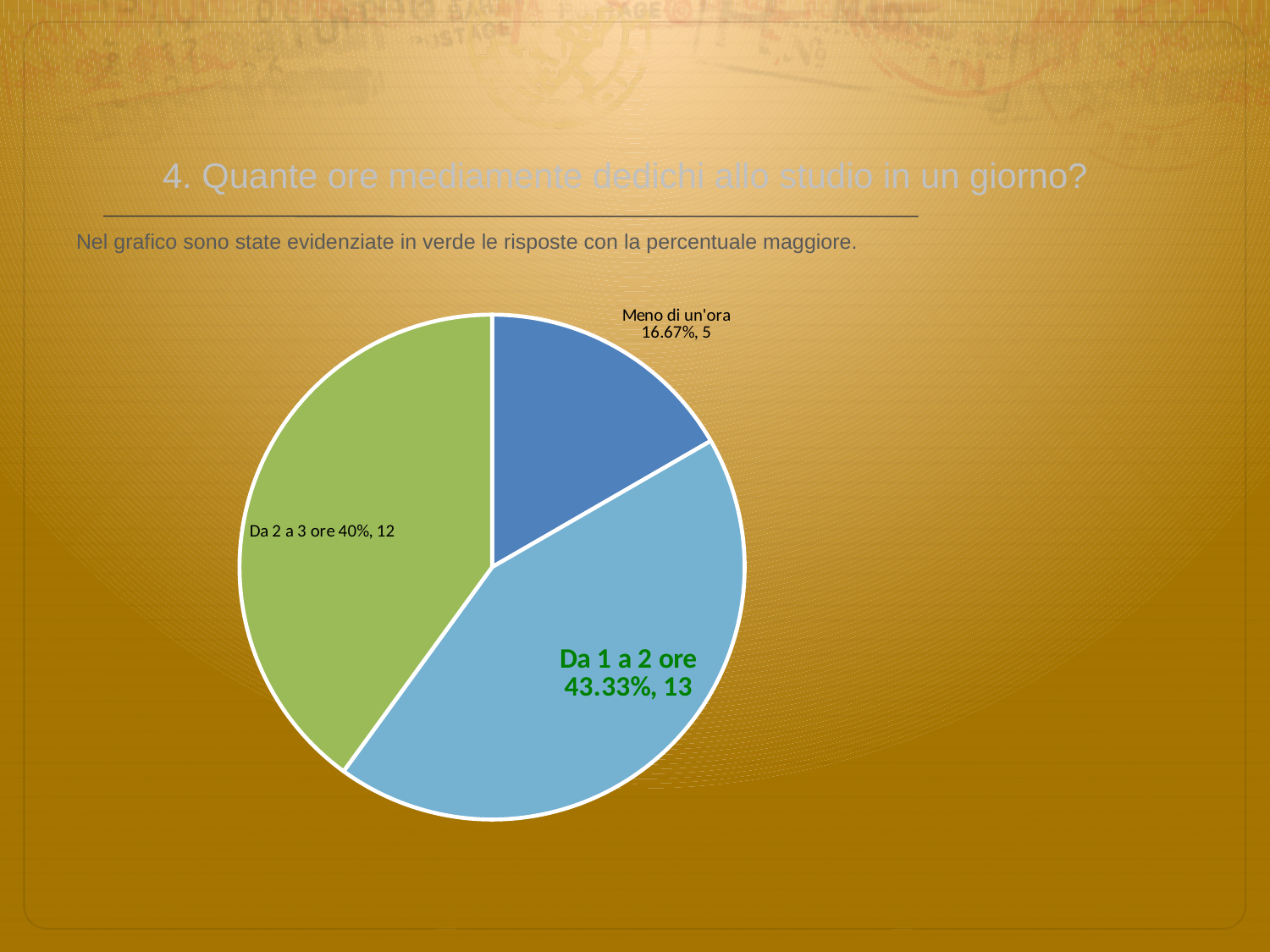
What count is shown for the 'Meno di un'ora' slice? 5 What percentage is shown for the 'Da 2 a 3 ore' slice? 40% What percentage is shown for the 'Da 1 a 2 ore' slice? 43.33% What is the difference in count between 'Da 1 a 2 ore' and 'Meno di un'ora'? 8 How many slices does the pie chart have? 3 What count is shown for the 'Da 2 a 3 ore' slice? 12 What is the total count across all three slices? 30 Which slice's label is highlighted in green on the chart? Da 1 a 2 ore What kind of chart is shown on the slide? pie chart Which category has the smallest share of the pie? Meno di un'ora Which has a larger count, 'Da 2 a 3 ore' or 'Meno di un'ora'? Da 2 a 3 ore Which category has the largest share of the pie? Da 1 a 2 ore